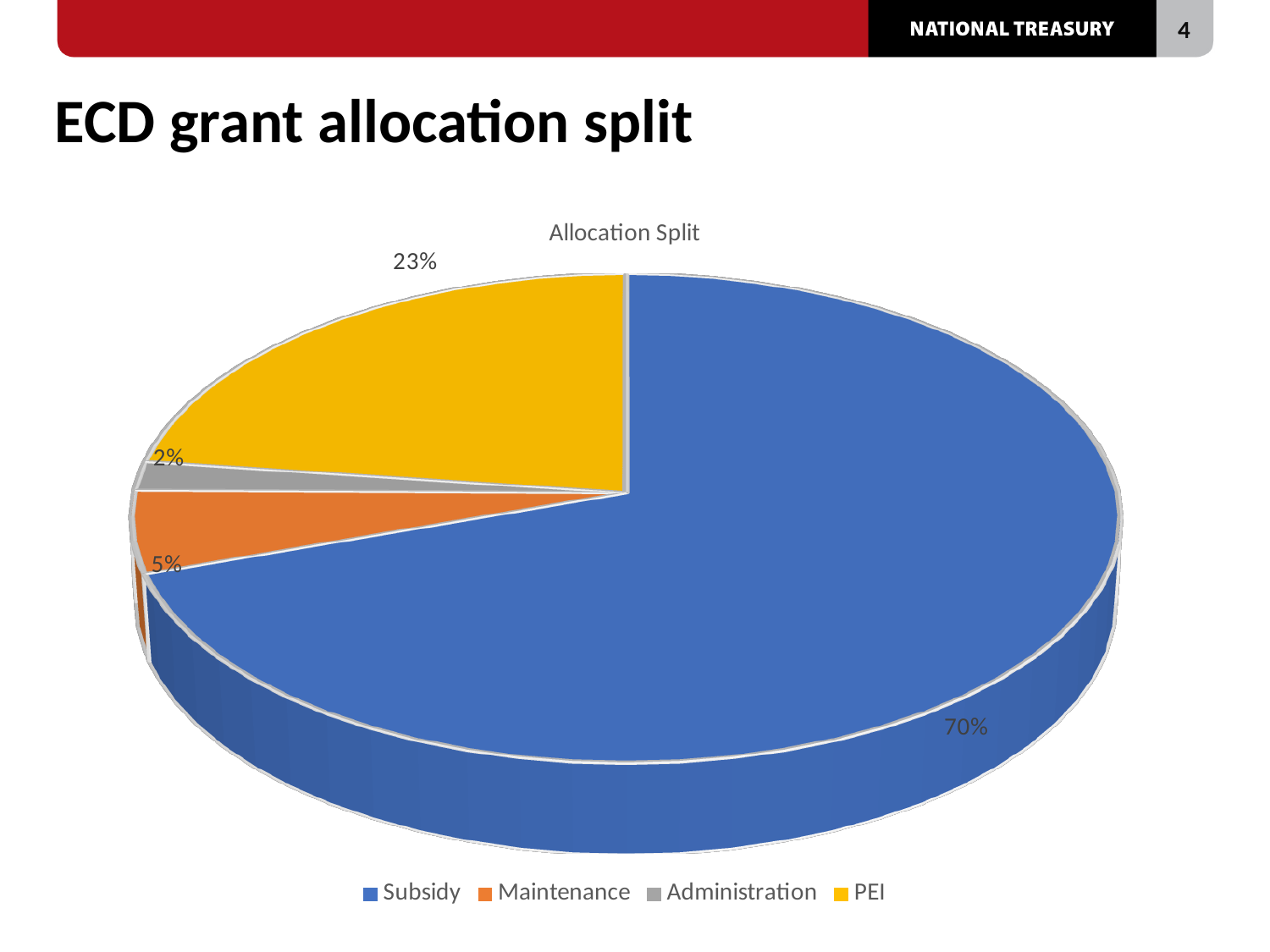
What is the title of the chart? Allocation Split What share of the pie does PEI take? 23% What is the difference in percentage points between Maintenance and Administration? 3 Which is larger, PEI or Maintenance? PEI What kind of chart is shown on the slide? Pie chart Which category has the largest slice? Subsidy What share of the pie does Subsidy take? 70% What share of the pie does Administration take? 2% How many categories does the pie chart show? 4 What is the difference in percentage points between Subsidy and PEI? 47 Which category has the smallest slice? Administration